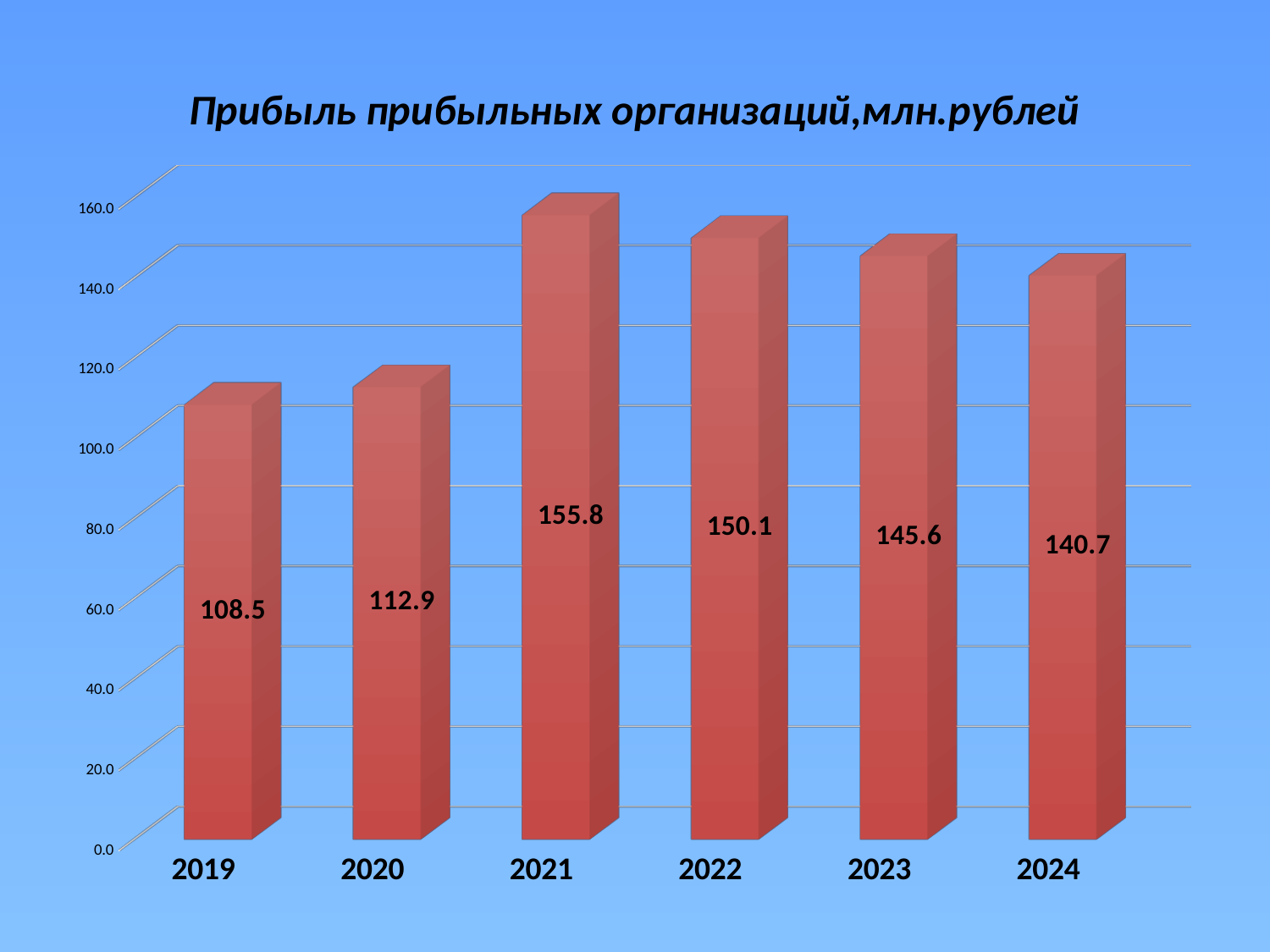
What is the value for 2021? 155.8 Do the values rise or fall from 2021 to 2024? fall What is the difference between the values for 2020 and 2019? 4.4 Which year has the lowest value? 2019 What is the value for 2024? 140.7 Which is larger, the value for 2022 or the value for 2023? 2022 What is the difference between the values for 2021 and 2024? 15.1 What kind of chart is shown on the slide? bar chart Is the value for 2020 greater or less than 120.0? less What is the value for 2019? 108.5 Which year has the highest value? 2021 How many years are shown on the chart? 6